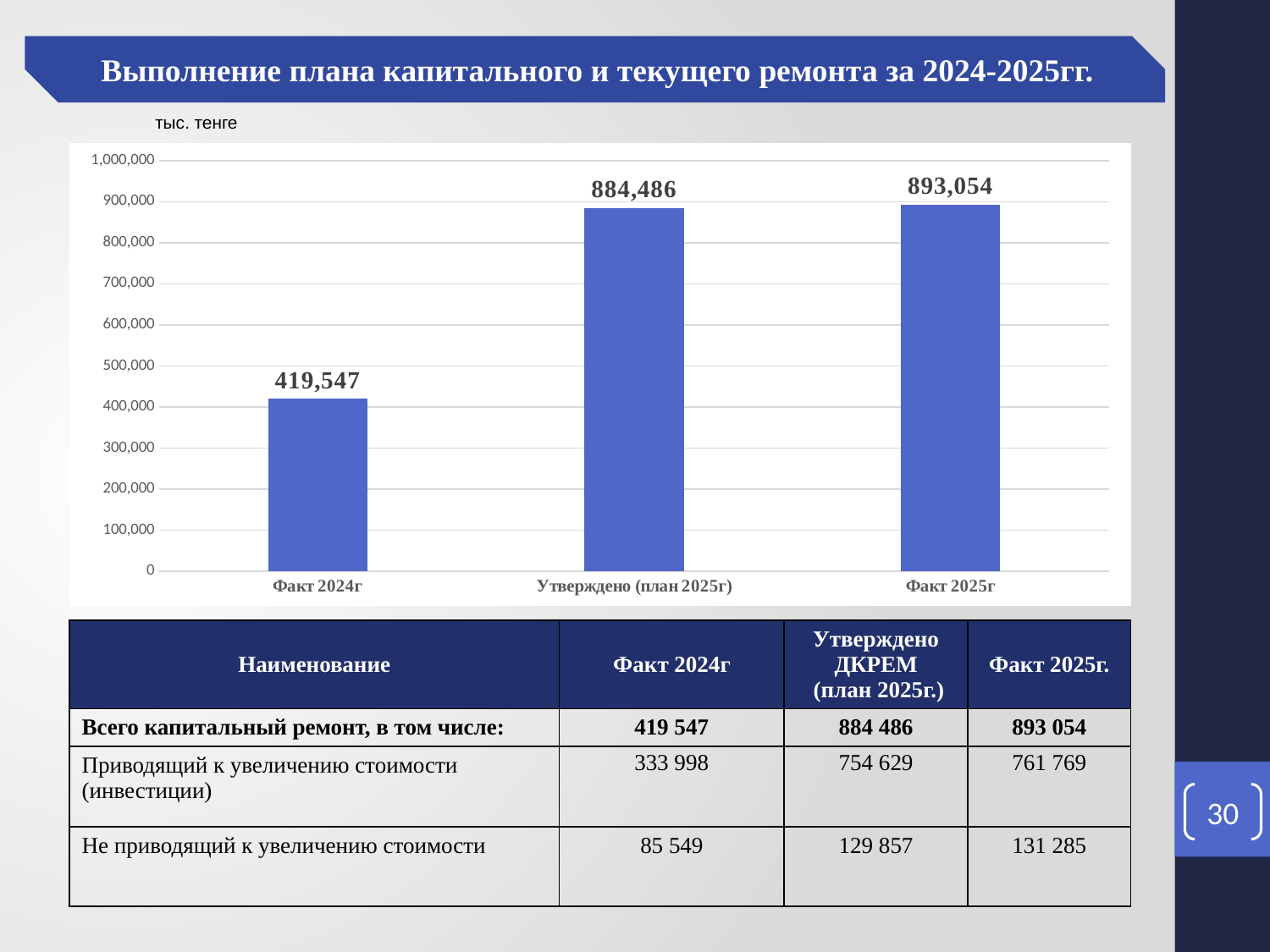
What unit label is shown above the chart? тыс. тенге What is the value for Факт 2024г? 419,547 What is the difference between Факт 2025г and Факт 2024г? 473,507 Is the value for Факт 2024г greater or less than 500,000? less What is the difference between Утверждено (план 2025г) and Факт 2024г? 464,939 Which category has the lowest value? Факт 2024г Which is larger, the value for Факт 2024г or the value for Утверждено (план 2025г)? Утверждено (план 2025г) How many categories are shown on the x axis? 3 What is the value for Утверждено (план 2025г)? 884,486 What kind of chart is shown on the slide? bar chart Which category has the highest value? Факт 2025г What is the value for Факт 2025г? 893,054